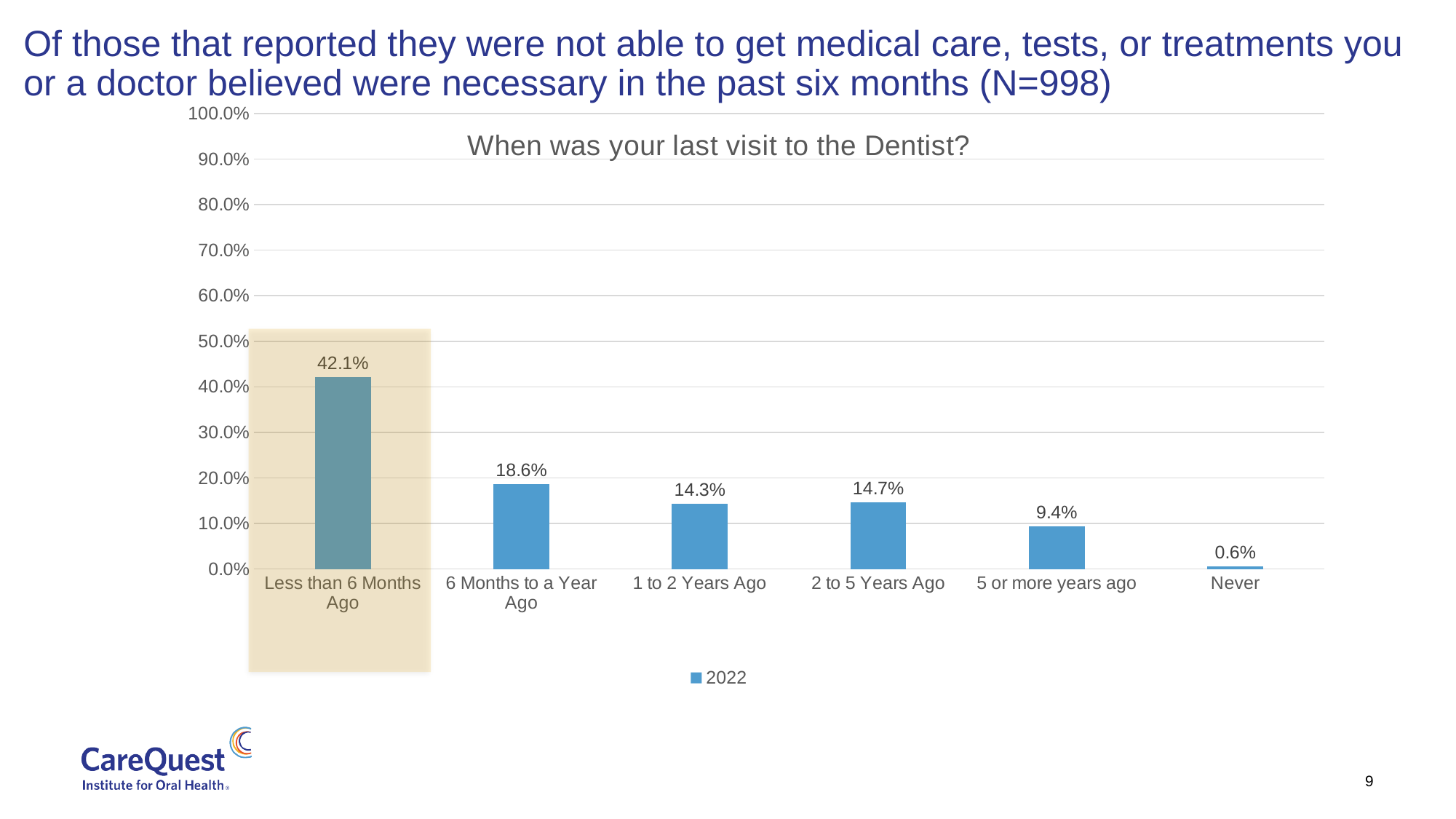
What is the value for '5 or more years ago'? 9.4% How many series does the legend list? 1 What kind of chart is shown? Bar chart Which category has the lowest value? Never What is the difference between the values for 'Less than 6 Months Ago' and '6 Months to a Year Ago'? 23.5% What is the value for 'Less than 6 Months Ago'? 42.1% Which is larger, the value for '1 to 2 Years Ago' or '2 to 5 Years Ago'? 2 to 5 Years Ago What is the value for '6 Months to a Year Ago'? 18.6% Is the value for '6 Months to a Year Ago' greater or less than 20.0%? less How many categories are shown on the x axis? 6 Which category has the highest value? Less than 6 Months Ago What is the value for 'Never'? 0.6%